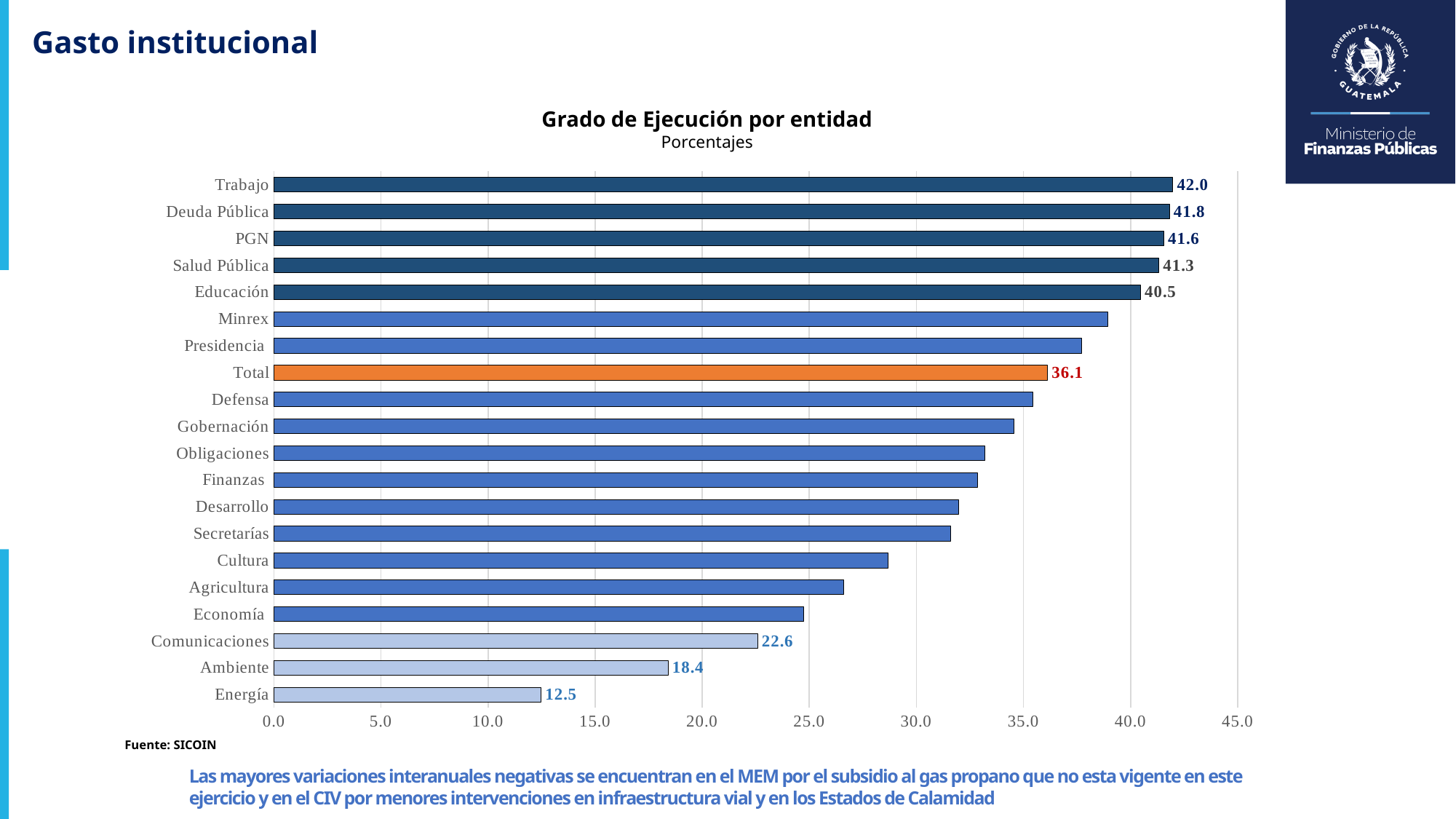
What is the difference between the values for Comunicaciones and Ambiente? 4.2 How many bars are shown in the chart? 20 What is the difference between the values for Trabajo and Energía? 29.5 Which entity has the lowest execution percentage? Energía What is the value for Energía? 12.5 Is the value for Agricultura greater or less than 30.0? less Is the value for Minrex greater or less than 35.0? greater Which entity has the highest execution percentage? Trabajo What is the value for Ambiente? 18.4 What is the value for Trabajo? 42.0 What is the value shown for the Total bar? 36.1 Which is larger, the value for Salud Pública or the value for Educación? Salud Pública